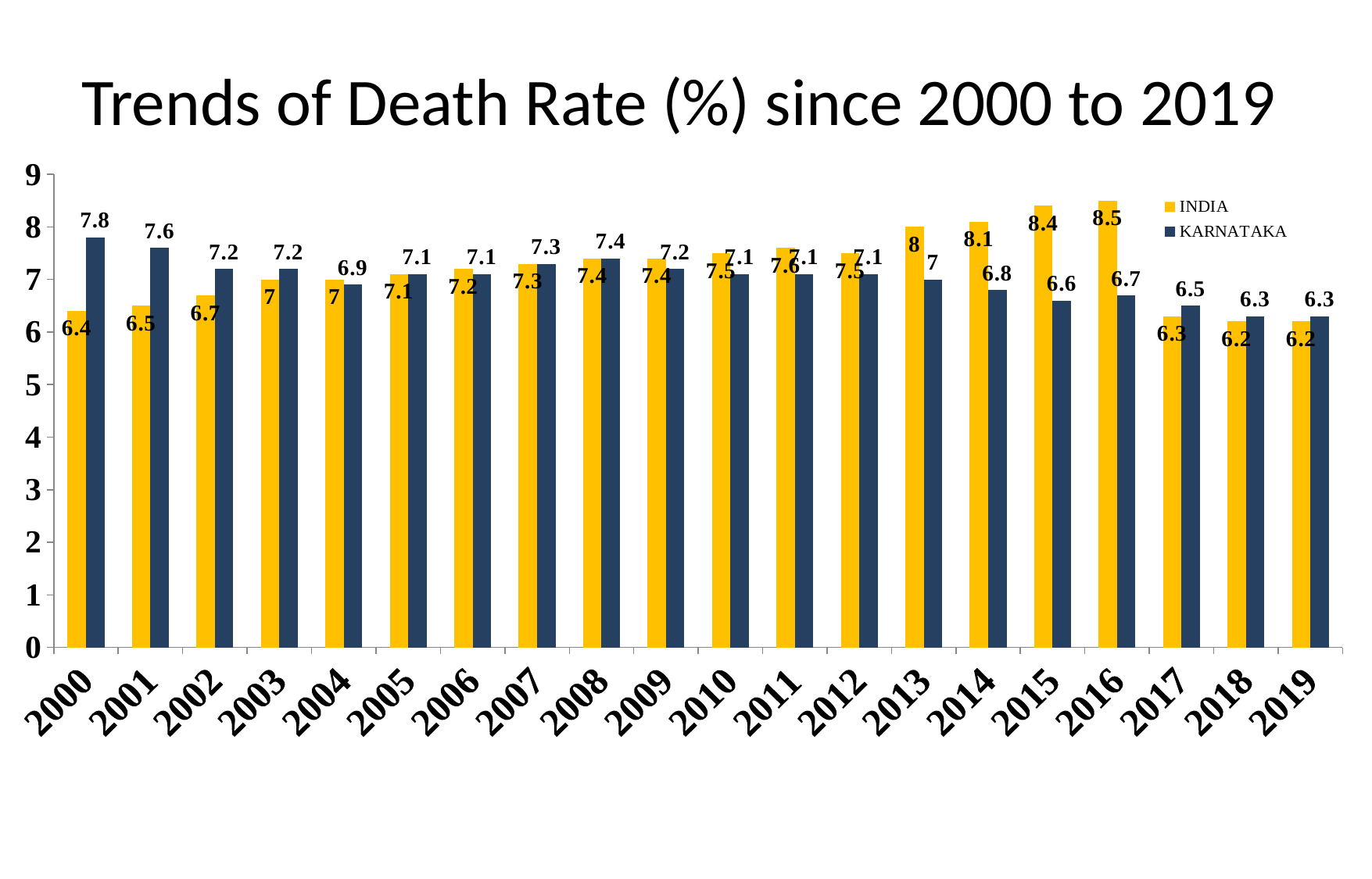
How many years are shown on the x axis? 20 What type of chart is shown on the slide? Bar chart What is the difference between the INDIA and KARNATAKA death rates in 2016? 1.8 In 2015, which is larger, the INDIA or the KARNATAKA death rate? INDIA What is the difference between the KARNATAKA and INDIA death rates in 2000? 1.4 What is the death rate for KARNATAKA in 2014? 6.8 What is the death rate for INDIA in 2003? 7 In which year is the INDIA death rate highest? 2016 In which year is the KARNATAKA death rate highest? 2000 What is the death rate for KARNATAKA in 2000? 7.8 What is the death rate for INDIA in 2016? 8.5 How many series does the legend list? 2